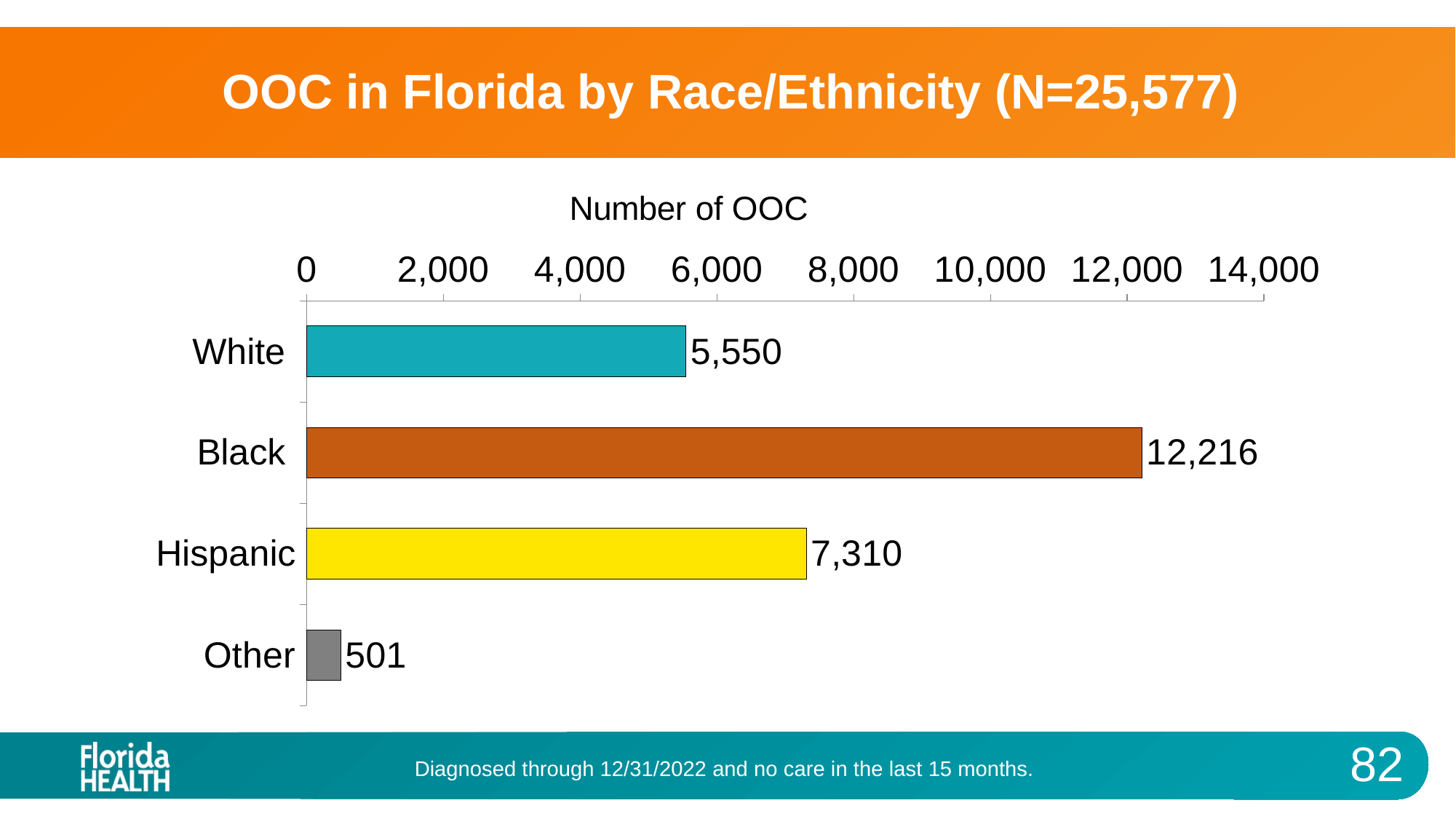
What kind of chart is shown on the slide? Bar chart Is the number of OOC for Black greater or less than 10,000? greater Which race/ethnicity category has the lowest number of OOC? Other What is the difference between the number of OOC for Hispanic and for White? 1,760 How many race/ethnicity categories are shown in the chart? 4 What is the number of OOC for Hispanic? 7,310 What is the number of OOC for Other? 501 Which race/ethnicity category has the highest number of OOC? Black What is the number of OOC for Black? 12,216 What is the difference between the number of OOC for Black and for Hispanic? 4,906 Which has a larger number of OOC, White or Hispanic? Hispanic What is the number of OOC for White? 5,550